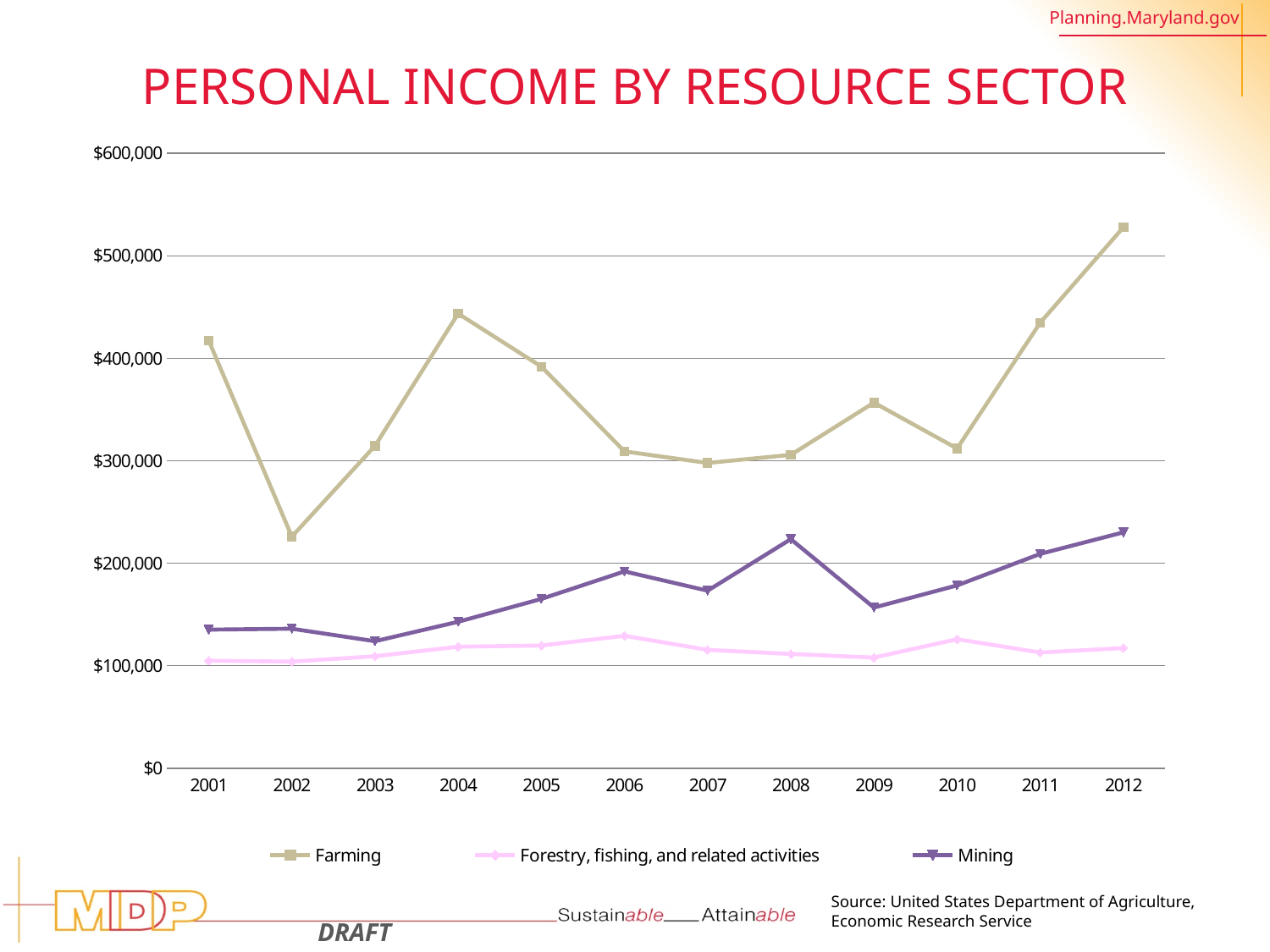
Which is larger for Farming: the value in 2004 or the value in 2005? 2004 In which year is the Farming series at its highest? 2012 What is the title of the chart? PERSONAL INCOME BY RESOURCE SECTOR In 2008, which is larger: Mining or Forestry, fishing, and related activities? Mining How many series does the legend list? 3 Is the Farming value for 2012 greater or less than $500,000? greater Is the Farming value for 2002 greater or less than $300,000? less Is the Mining value for 2008 greater or less than $200,000? greater Does the Farming series rise or fall from 2010 to 2012? rise In which year is the Farming series at its lowest? 2002 What kind of chart is shown on the slide? line chart How many years are plotted along the x axis? 12